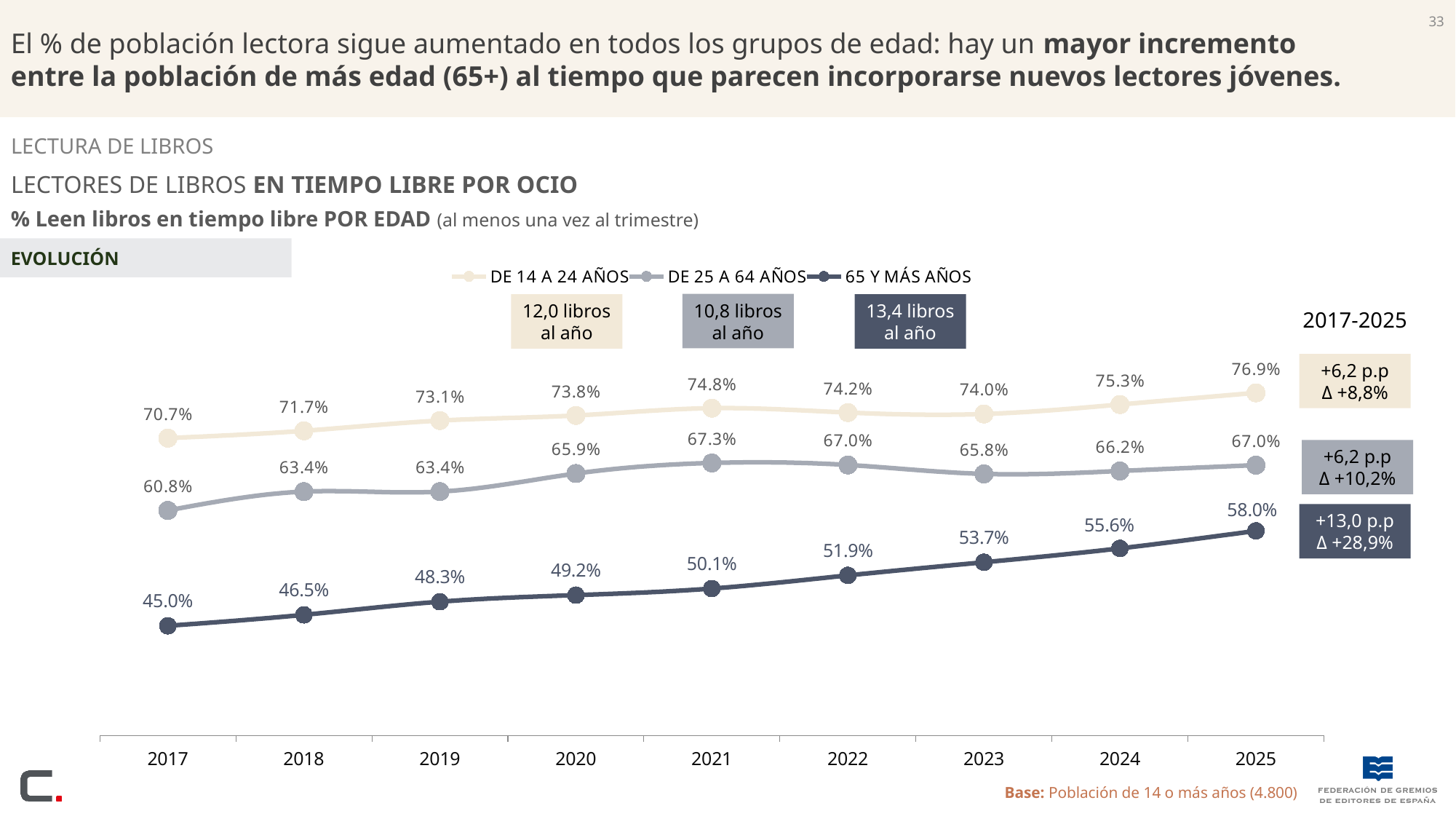
How many books per year are shown in the box for the 65 Y MÁS AÑOS group? 13,4 libros al año What is the value for DE 25 A 64 AÑOS in 2021? 67.3% What is the value for DE 14 A 24 AÑOS in 2025? 76.9% In which year is the value for 65 Y MÁS AÑOS highest? 2025 What kind of chart is shown? Line chart Does the value for 65 Y MÁS AÑOS rise or fall from 2017 to 2025? Rise Which is larger in 2020: the value for DE 25 A 64 AÑOS or for 65 Y MÁS AÑOS? DE 25 A 64 AÑOS What is the value for 65 Y MÁS AÑOS in 2017? 45.0% In which year is the value for DE 25 A 64 AÑOS lowest? 2017 How many series does the legend list? 3 How many years are shown on the x axis? 9 What is the difference between the DE 14 A 24 AÑOS and 65 Y MÁS AÑOS values in 2025? 18.9 p.p.